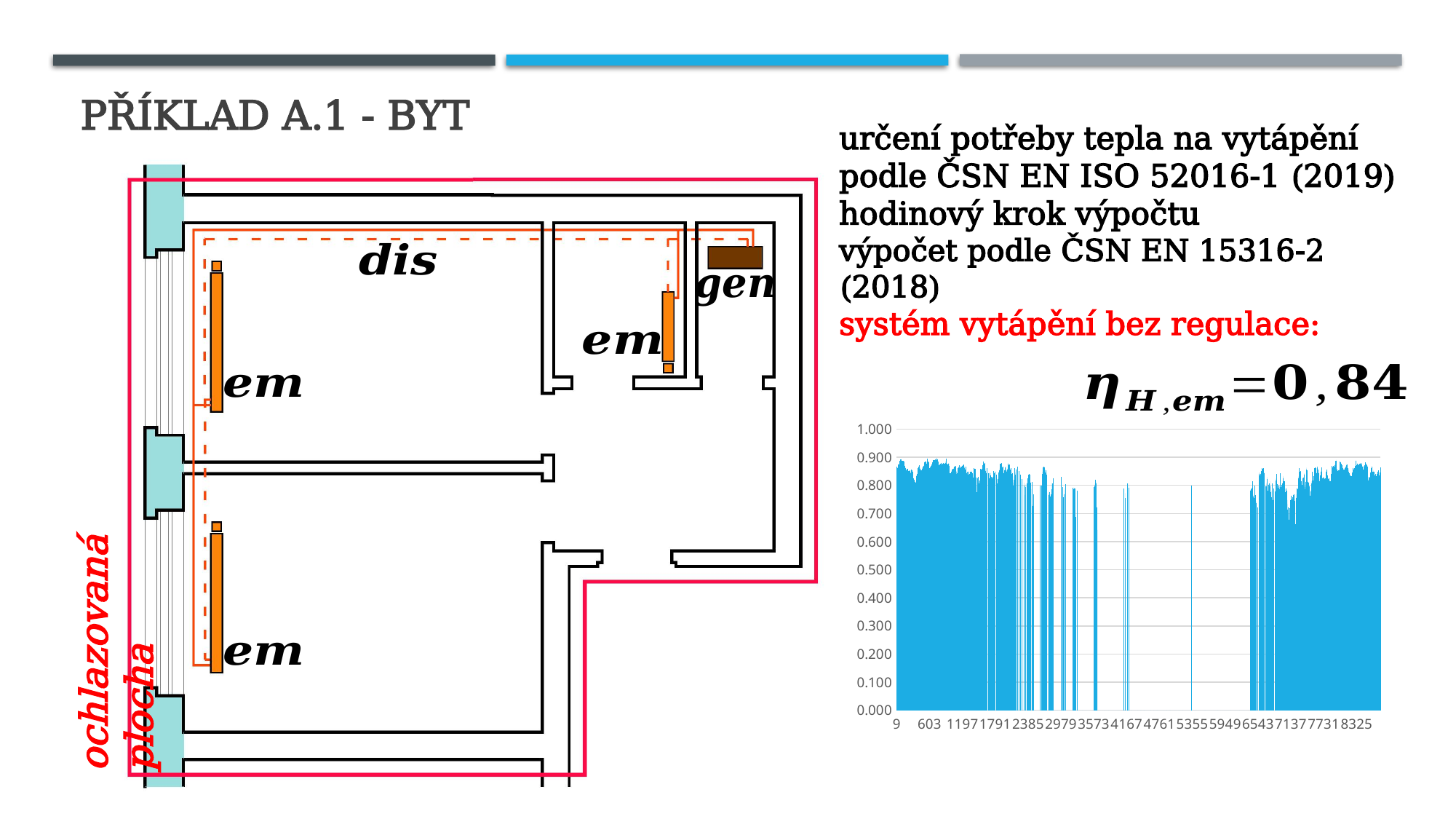
Are the bar values near the horizontal-axis tick 7731 greater or less than 0.500? greater Are the bar values near the horizontal-axis tick 4761 greater or less than 0.100? less What is the last tick label on the horizontal axis of the chart? 8325 Which region of the chart has higher bar values: around tick 603 or around tick 5355? around tick 603 Do the bar values rise or fall when moving from the tick 1197 toward the tick 4761 along the horizontal axis? fall What is the first tick label on the horizontal axis of the chart? 9 What is the highest value labelled on the vertical axis of the chart? 1.000 What kind of chart is shown on the right side of the slide? bar chart What is the lowest value labelled on the vertical axis of the chart? 0.000 Are the bar values near the horizontal-axis tick 9 greater or less than 0.900? less How many tick labels are shown along the horizontal axis of the chart? 15